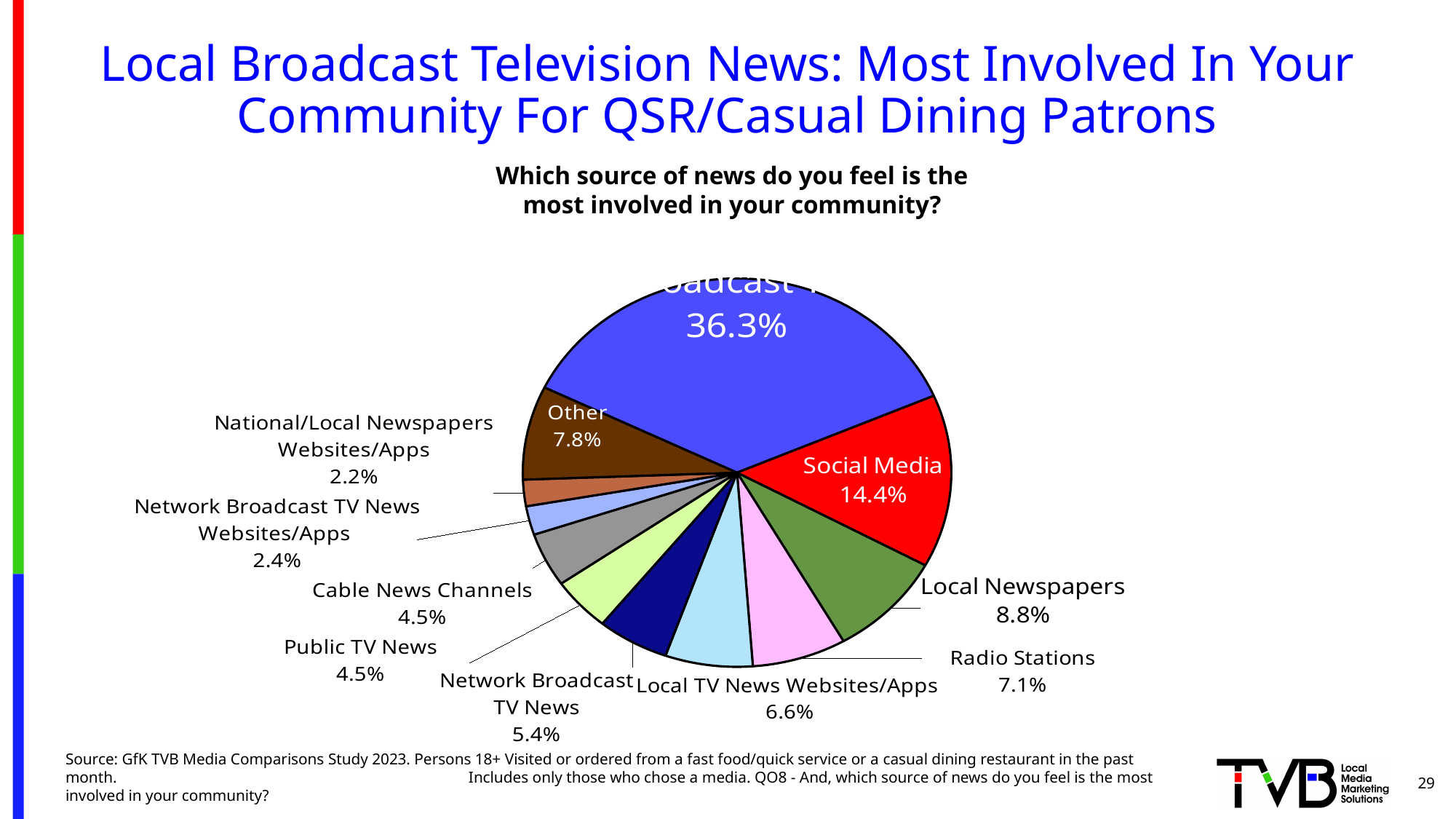
What is the value for Radio Stations? 7.1% What is the value for Local Newspapers? 8.8% What is the value for Other? 7.8% What is the value for Network Broadcast TV News? 5.4% What kind of chart is shown on the slide? pie chart What share of the pie does Social Media hold? 14.4% How many slices does the pie chart have? 11 What percentage is shown on the largest slice of the pie? 36.3% What question is shown as the chart's subtitle? Which source of news do you feel is the most involved in your community? What is the difference between Social Media and Local Newspapers? 5.6% Which is larger, Radio Stations or Local TV News Websites/Apps? Radio Stations Which category has the smallest slice of the pie? National/Local Newspapers Websites/Apps